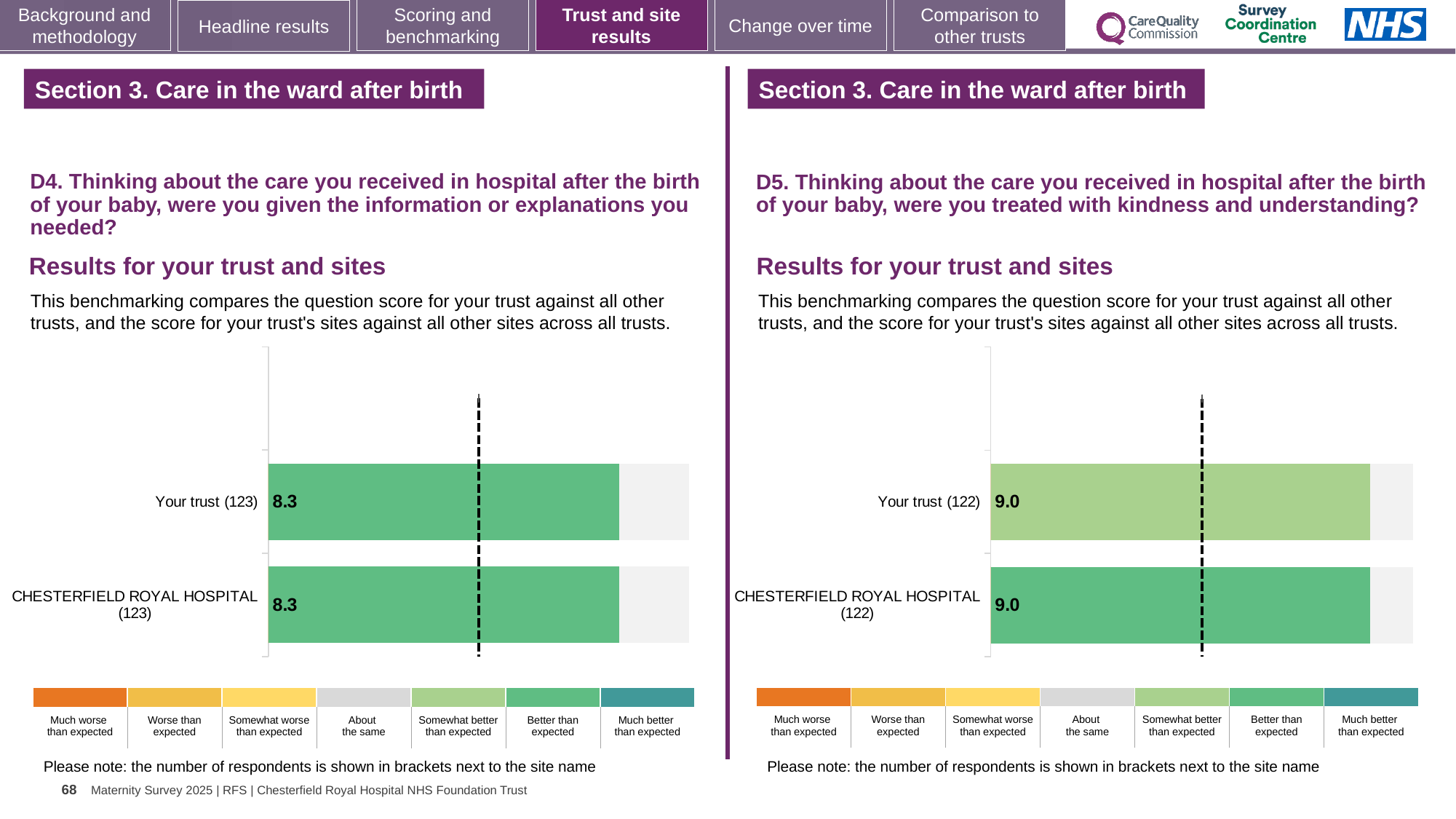
In the D4 chart on the left, how many respondents are shown in brackets for Your trust? 123 In the D4 chart on the left, what is the score for Your trust? 8.3 In the D5 chart on the right, what is the score for Your trust? 9.0 In the D5 chart on the right, is the score for Your trust larger than, smaller than, or equal to the score for Chesterfield Royal Hospital? equal In the D4 chart on the left, what is the difference between the score for Your trust and the score for Chesterfield Royal Hospital? 0.0 How many bars are plotted in the D5 chart on the right? 2 Is the score for Your trust in the D5 chart on the right greater or less than the score for Your trust in the D4 chart on the left? greater In the D5 chart on the right, how many respondents are shown in brackets for Chesterfield Royal Hospital? 122 How many bars are plotted in the D4 chart on the left? 2 In the D5 chart on the right, what is the score for Chesterfield Royal Hospital? 9.0 What kind of chart is the D4 chart on the left? bar chart In the D4 chart on the left, what is the score for Chesterfield Royal Hospital? 8.3